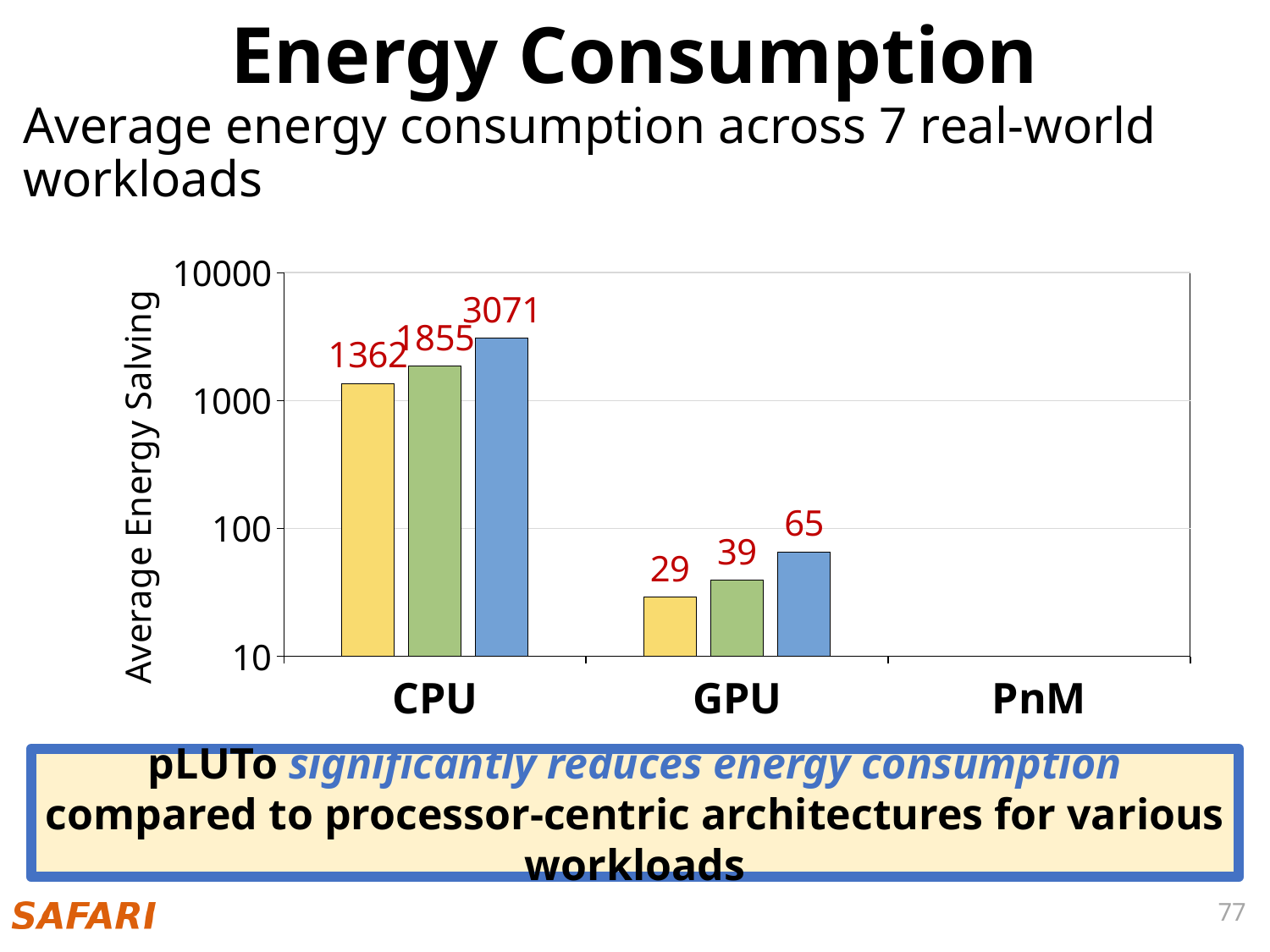
What is the value of the yellow bar for GPU? 29 What kind of chart is shown on the slide? Bar chart Which category has the highest labelled value on the chart? CPU What is the difference between the blue bar and the yellow bar for CPU? 1709 What is the value of the yellow bar for CPU? 1362 What is the value of the blue bar for CPU? 3071 What is the value of the blue bar for GPU? 65 How many categories are shown on the x axis? 3 What is the difference between the green bar and the yellow bar for GPU? 10 What is the value of the green bar for CPU? 1855 Which is larger, the green bar for CPU or the blue bar for GPU? The green bar for CPU Is the value of the green bar for GPU greater or less than 100? less